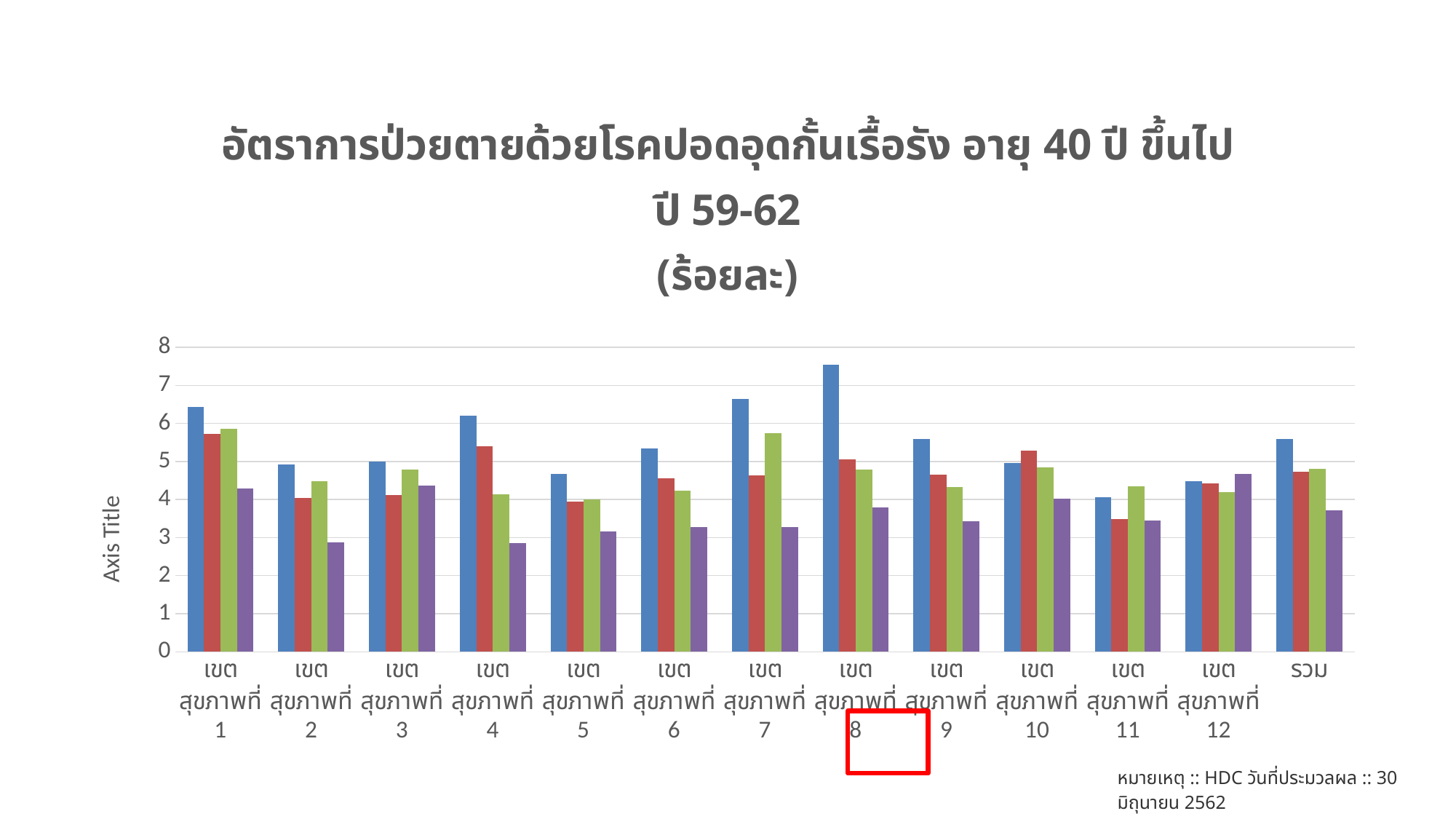
Is the red bar for เขตสุขภาพที่ 11 greater or less than 4? less How many bars are plotted for each category in the chart? 4 Which is larger, the blue bar for เขตสุขภาพที่ 8 or the blue bar for เขตสุขภาพที่ 1? เขตสุขภาพที่ 8 What is the label shown on the vertical axis of the chart? Axis Title What kind of chart is shown on the slide? bar chart Which category has the tallest blue bar in the chart? เขตสุขภาพที่ 8 Is the blue bar for เขตสุขภาพที่ 7 greater or less than 6? greater Is the blue bar for เขตสุขภาพที่ 8 greater or less than 7? greater Which category has the shortest blue bar in the chart? เขตสุขภาพที่ 11 What is the label of the last category on the x axis of the chart? รวม How many categories are shown along the x axis of the chart? 13